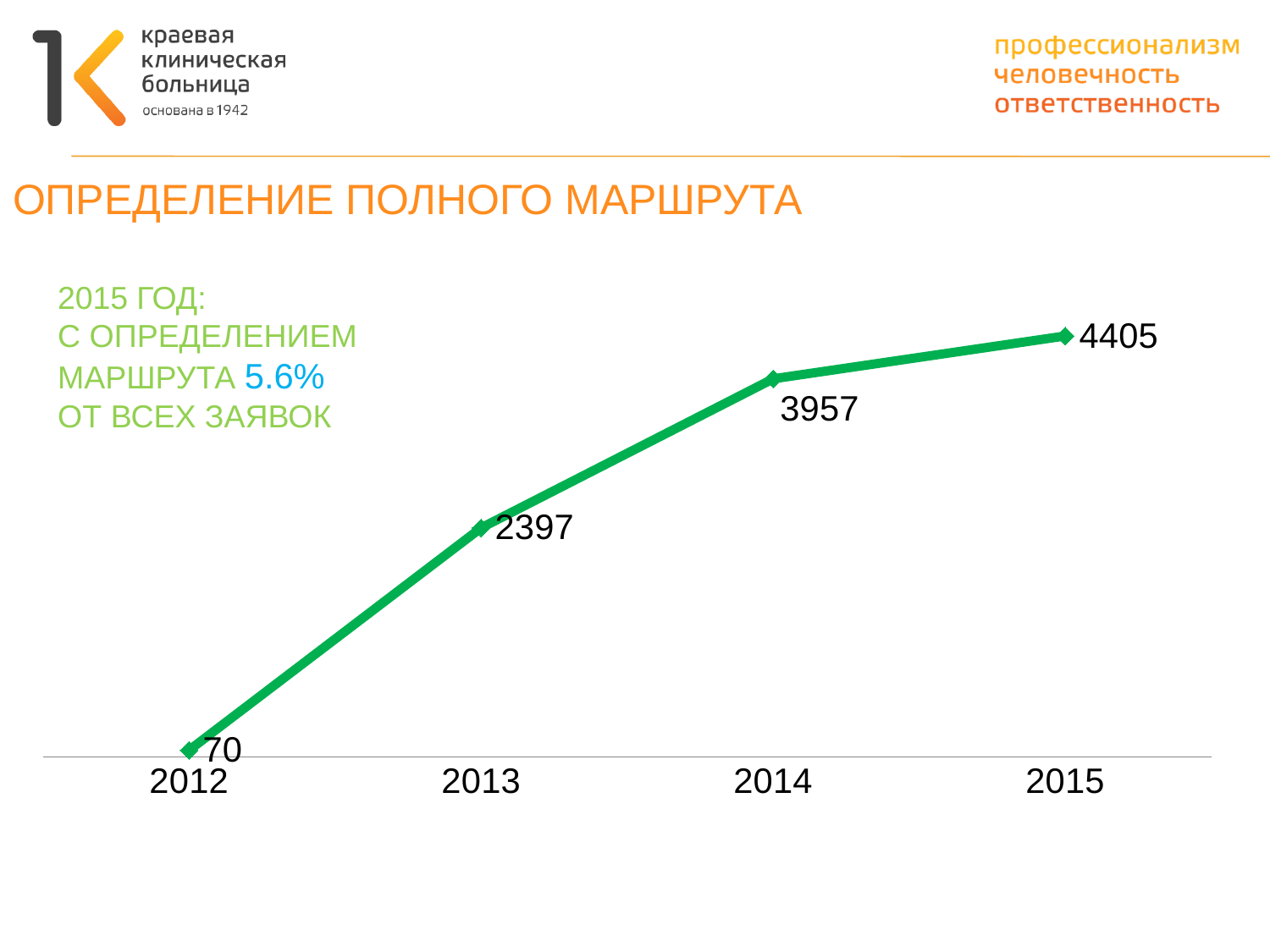
Which is larger, the value for 2013 or the value for 2014? 2014 What is the value for 2015? 4405 How many data points are plotted on the chart? 4 What is the value for 2013? 2397 Which year has the lowest value? 2012 What is the difference between the values for 2015 and 2014? 448 Do the values rise or fall from 2012 to 2015? rise What kind of chart is shown on the slide? line chart What is the value for 2012? 70 What is the value for 2014? 3957 Which year has the highest value? 2015 What is the difference between the values for 2013 and 2012? 2327